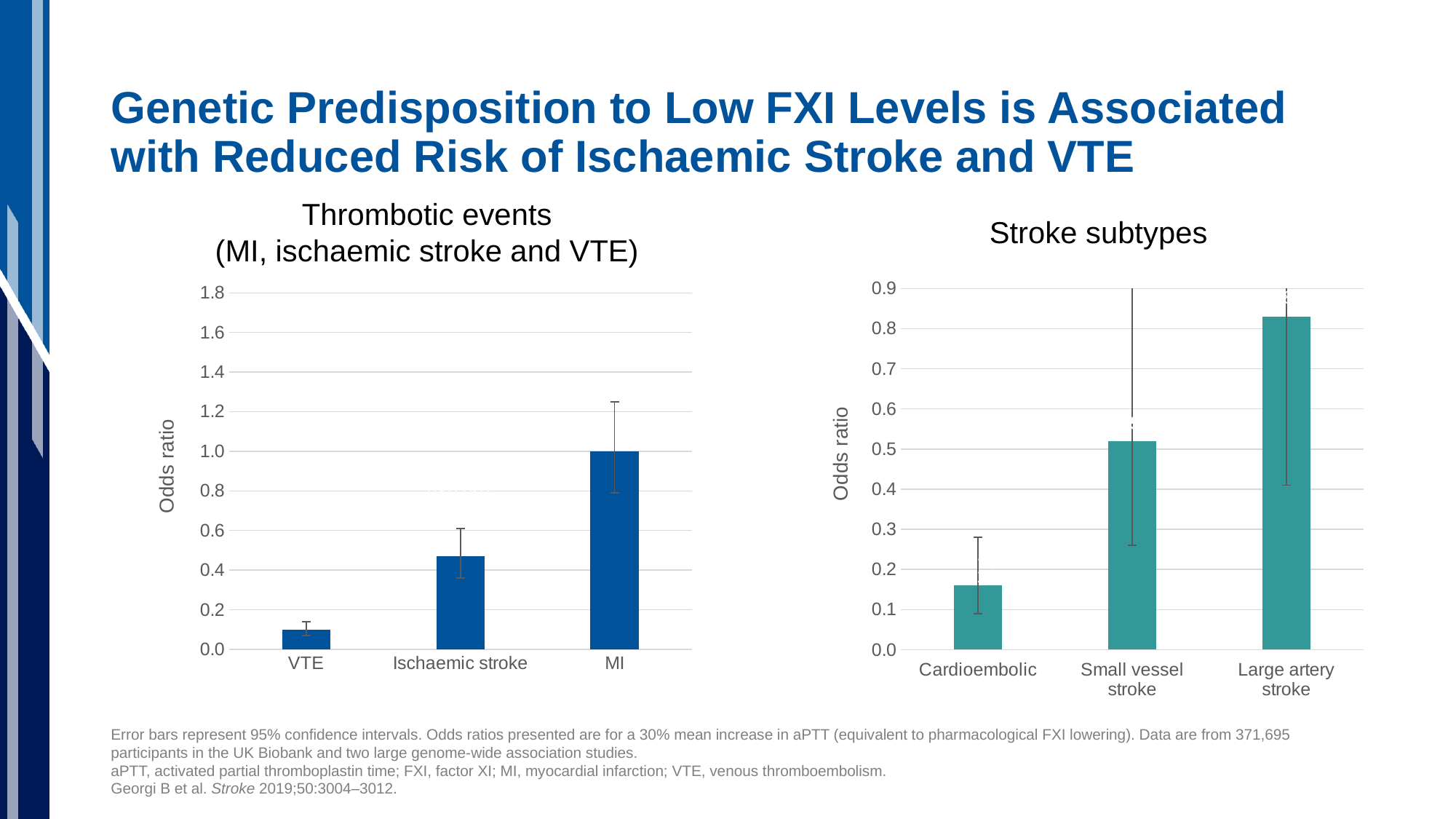
In the 'Thrombotic events' chart, which category has the highest odds ratio? MI In the 'Thrombotic events' chart, what is the odds ratio for MI? 1.0 In the 'Stroke subtypes' chart, which category has the highest odds ratio? Large artery stroke How many categories are shown in the 'Thrombotic events' chart? 3 In the 'Thrombotic events' chart, which category has the lowest odds ratio? VTE What type of chart is the 'Thrombotic events' chart on the left? bar chart In the 'Thrombotic events' chart, is the odds ratio for Ischaemic stroke greater or less than 0.6? less In the 'Stroke subtypes' chart, which category has the lowest odds ratio? Cardioembolic What is the y-axis label of the 'Stroke subtypes' chart? Odds ratio In the 'Stroke subtypes' chart, is the odds ratio for Small vessel stroke greater or less than 0.4? greater In the 'Stroke subtypes' chart, is the odds ratio for Cardioembolic greater or less than 0.2? less